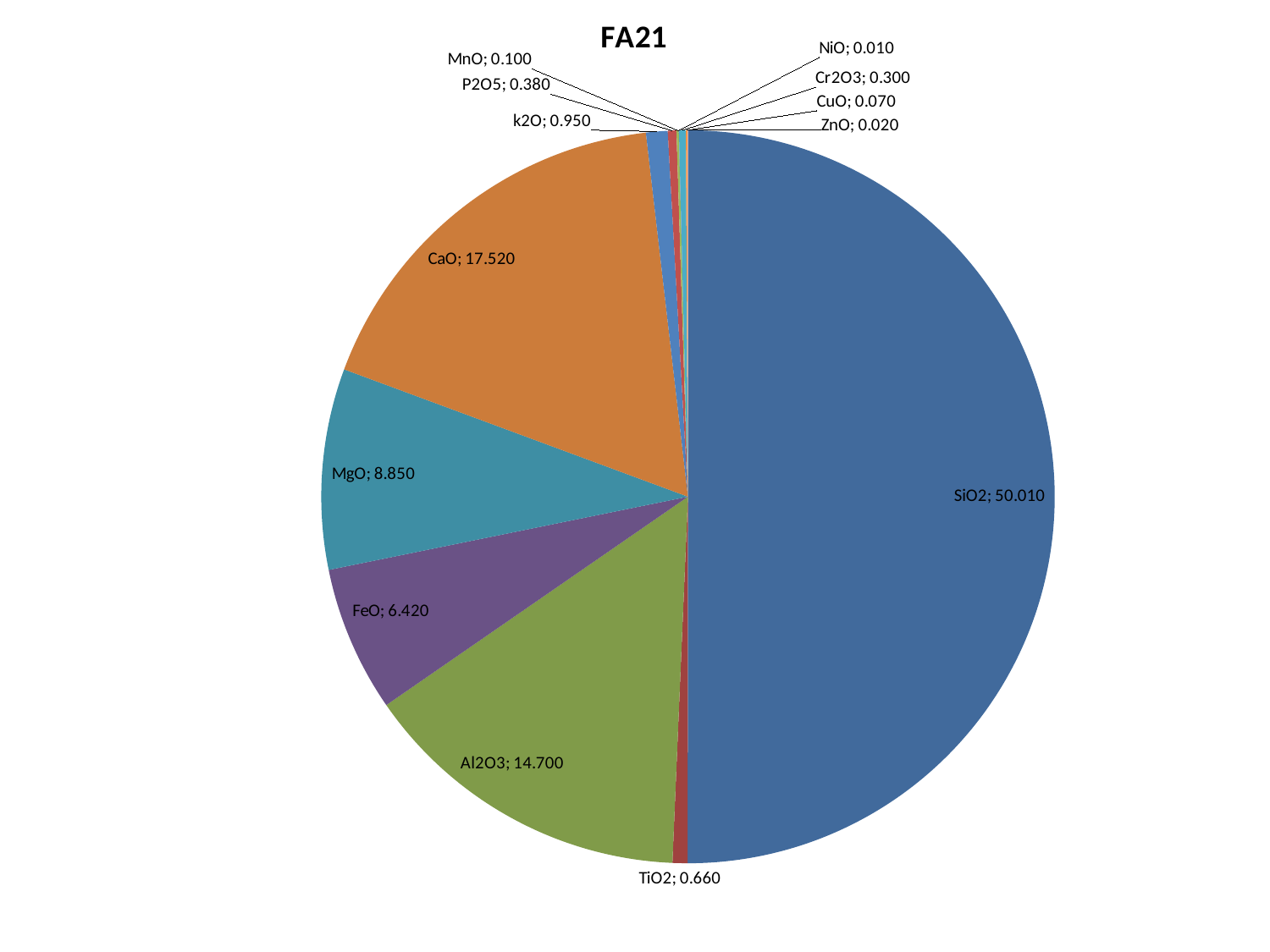
Which component has the smallest value in the FA21 pie chart? NiO What is the value shown for CaO in the FA21 pie chart? 17.520 What is the value shown for SiO2 in the FA21 pie chart? 50.010 Which is larger in the FA21 pie chart, MgO or FeO? MgO What is the value shown for NiO in the FA21 pie chart? 0.010 What is the value shown for TiO2 in the FA21 pie chart? 0.660 How many slices does the FA21 pie chart have? 13 What is the difference between the MgO and FeO values in the FA21 pie chart? 2.430 What is the value shown for Al2O3 in the FA21 pie chart? 14.700 What is the difference between the CaO and Al2O3 values in the FA21 pie chart? 2.820 Which component has the largest slice in the FA21 pie chart? SiO2 What type of chart is shown on the slide? Pie chart